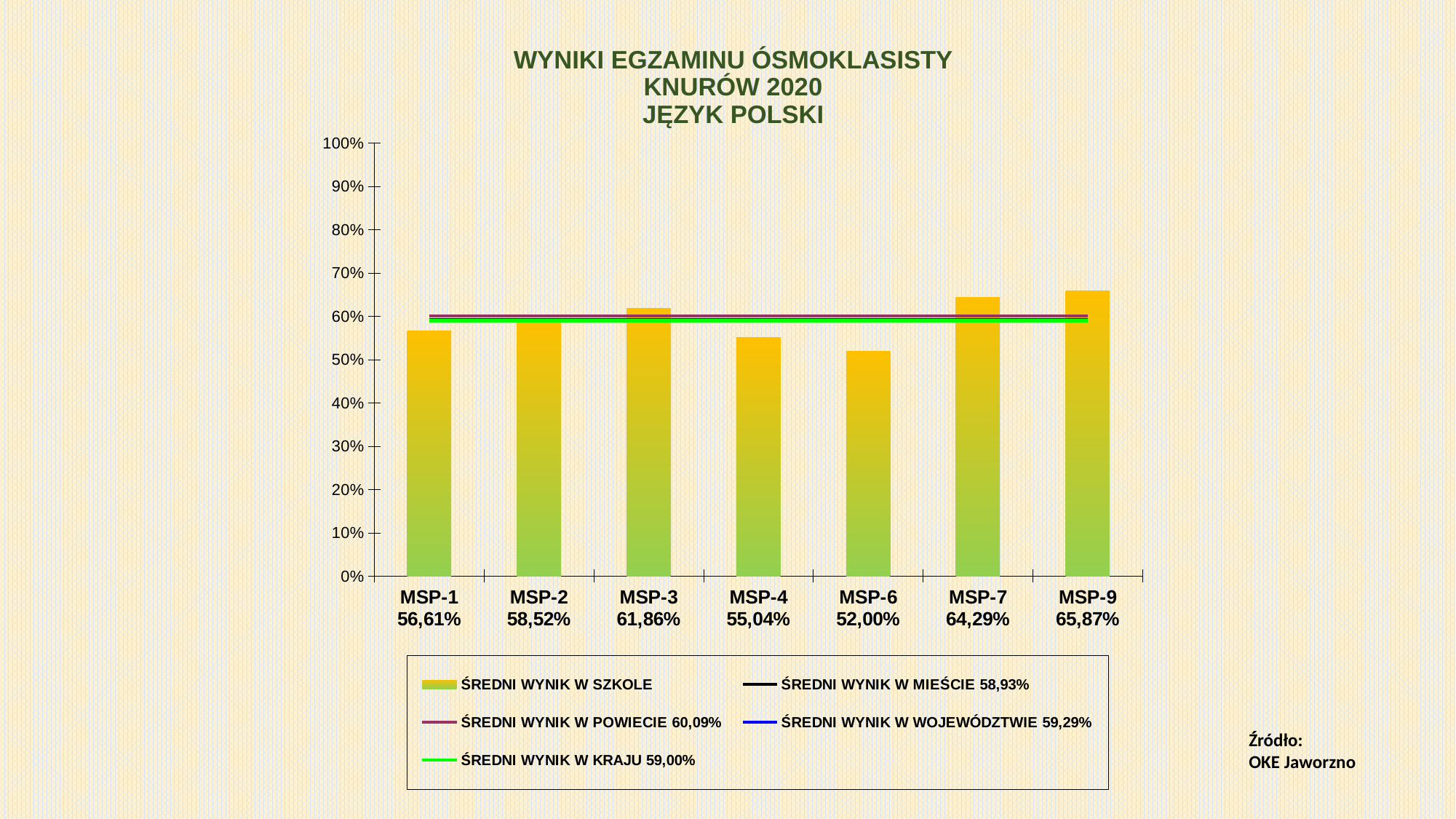
Which school has the highest average result? MSP-9 What is the source cited on the slide? OKE Jaworzno What is the average result for MSP-6? 52,00% How many schools are shown on the chart? 7 Which school has the lowest average result? MSP-6 What kind of chart is shown on the slide? bar chart Is the value for MSP-7 greater or less than 60%? greater Which has a higher average result, MSP-1 or MSP-2? MSP-2 What is the average result for MSP-3? 61,86% What is the value of ŚREDNI WYNIK W POWIECIE shown in the legend? 60,09% What is the difference between the results of MSP-9 and MSP-6? 13,87% How many series does the legend list? 5